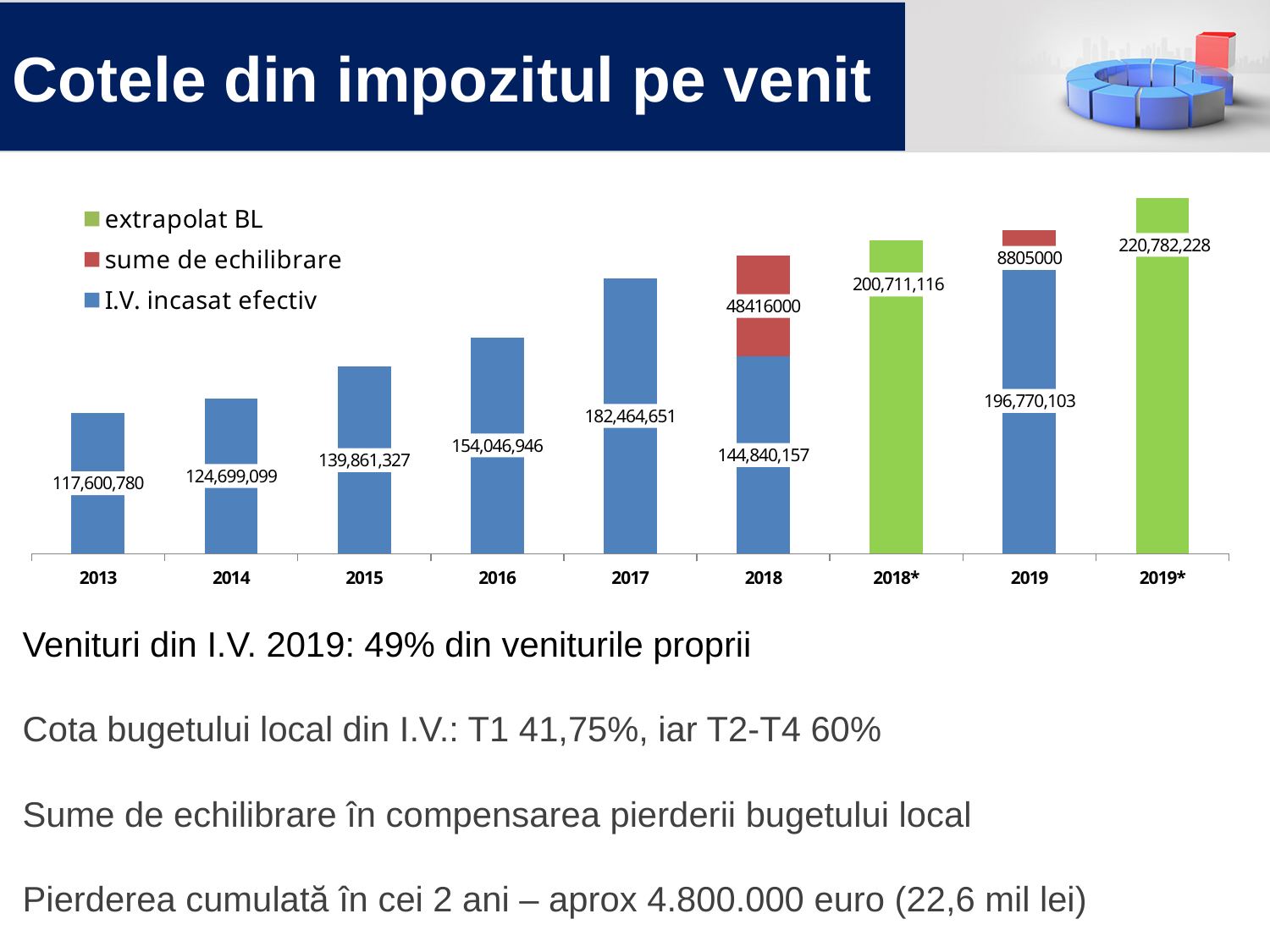
How many series does the legend list? 3 What is the total of the stacked bar for 2019? 205,575,103 What type of chart is shown on the slide? bar chart What is the value of I.V. incasat efectiv for 2017? 182,464,651 What is the value of I.V. incasat efectiv for 2013? 117,600,780 Which is larger: the extrapolat BL value for 2018* or the I.V. incasat efectiv value for 2019? 2018* extrapolat BL Which category has the tallest bar overall? 2019* What is the value of sume de echilibrare for 2018? 48416000 What is the difference between I.V. incasat efectiv in 2017 and in 2016? 28,417,705 How many categories are shown on the x axis? 9 Which category has the lowest value of I.V. incasat efectiv? 2013 What is the value of extrapolat BL for 2019*? 220,782,228